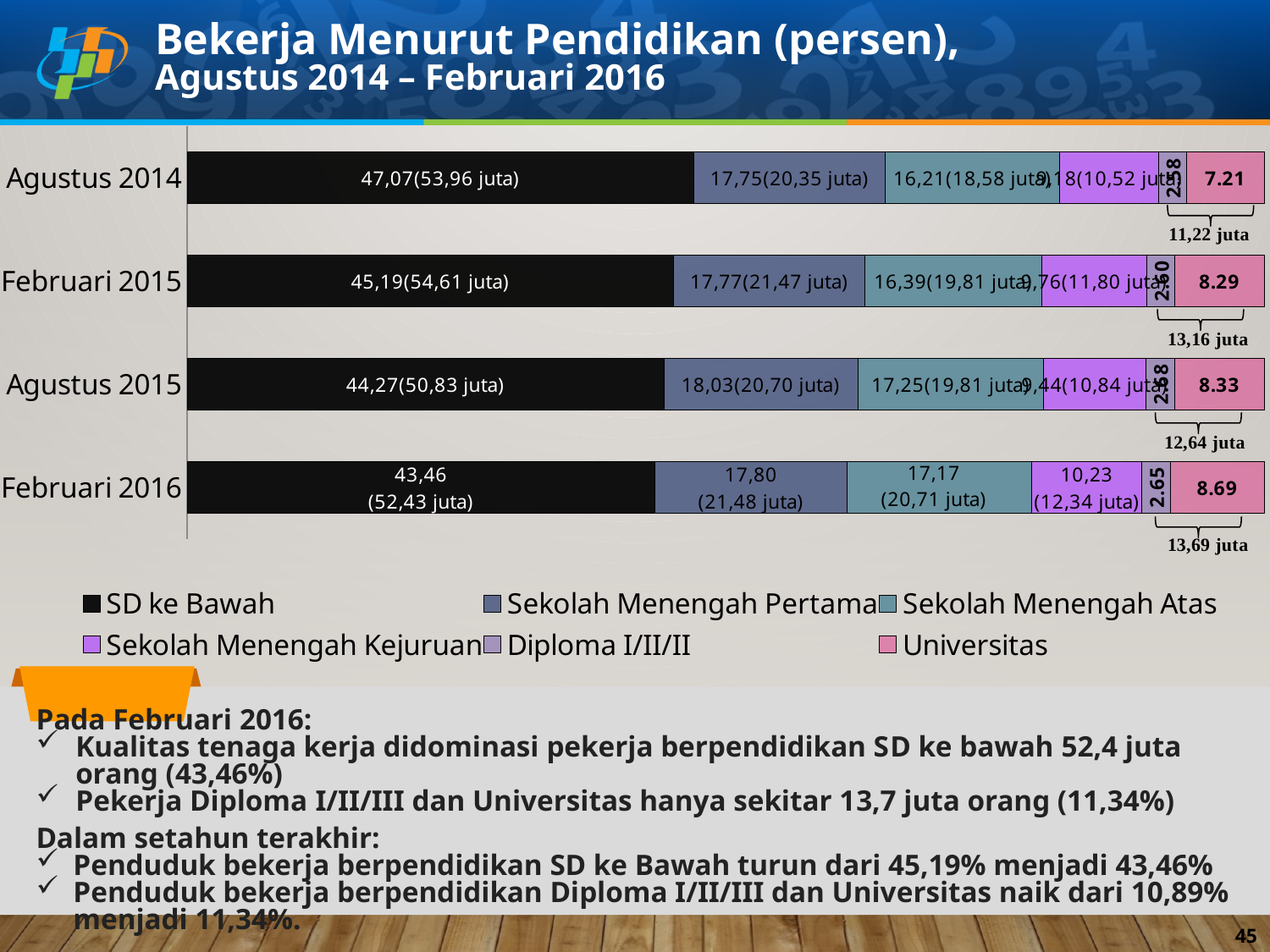
In Februari 2016, which is larger: the percentage for Sekolah Menengah Pertama or for Sekolah Menengah Atas? Sekolah Menengah Pertama What is the percentage value for Sekolah Menengah Pertama in Agustus 2015? 18,03 What is the difference between the Universitas value in Februari 2016 and in Agustus 2014? 1.48 How many workers (in juta) had Sekolah Menengah Atas education in Februari 2016? 20,71 juta Does the SD ke Bawah percentage rise or fall from Agustus 2014 to Februari 2016? Fall How many series does the legend list? 6 What is the value for Universitas in Agustus 2014? 7.21 In which period is the SD ke Bawah percentage the lowest? Februari 2016 How many periods (categories) are shown on the chart? 4 What is the percentage value for SD ke Bawah in Februari 2016? 43,46 What kind of chart is shown on the slide? Stacked bar chart In which period is the Universitas value the highest? Februari 2016